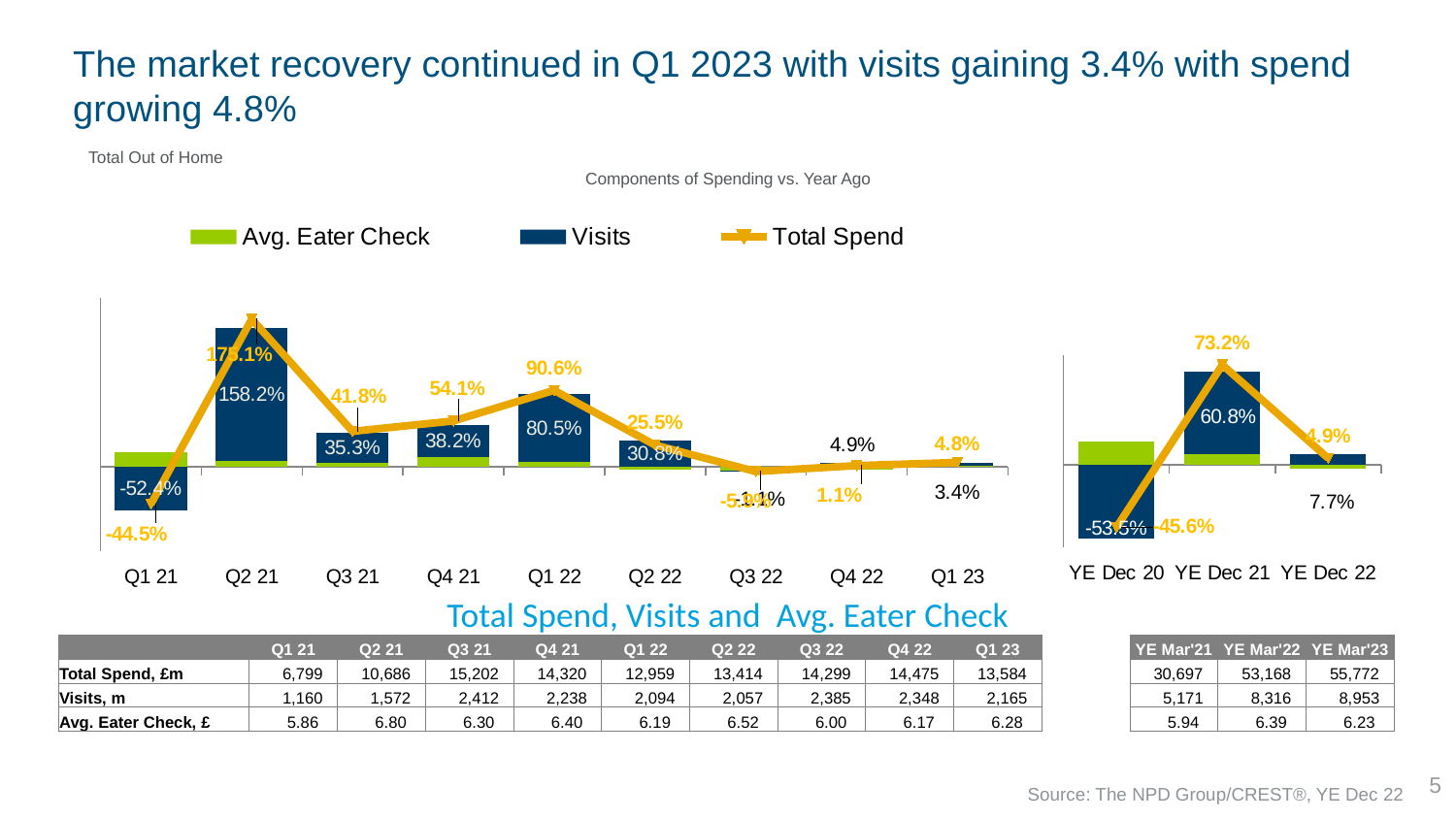
In the left chart (Components of Spending vs. Year Ago), what is the Total Spend value for Q4 21? 54.1% In the right chart (YE Dec 20 to YE Dec 22), what is the Visits value for YE Dec 22? 7.7% In the left chart (Components of Spending vs. Year Ago), which is larger: the Visits value for Q1 22 or for Q2 22? Q1 22 In the left chart (Components of Spending vs. Year Ago), what is the Total Spend value for Q1 23? 4.8% In the right chart (YE Dec 20 to YE Dec 22), what is the Total Spend value for YE Dec 21? 73.2% In the left chart (Components of Spending vs. Year Ago), what is the difference between the Visits values for Q4 21 and Q3 21? 2.9 percentage points In the left chart (Components of Spending vs. Year Ago), which quarter has the lowest Total Spend value? Q1 21 In the left chart (Components of Spending vs. Year Ago), which quarter has the highest Visits value? Q2 21 In the left chart (Components of Spending vs. Year Ago), what is the Visits value for Q3 21? 35.3% How many quarters are shown on the x axis of the left chart (Components of Spending vs. Year Ago)? 9 In the left chart (Components of Spending vs. Year Ago), what is the Visits value for Q1 22? 80.5% How many series does the legend list? 3